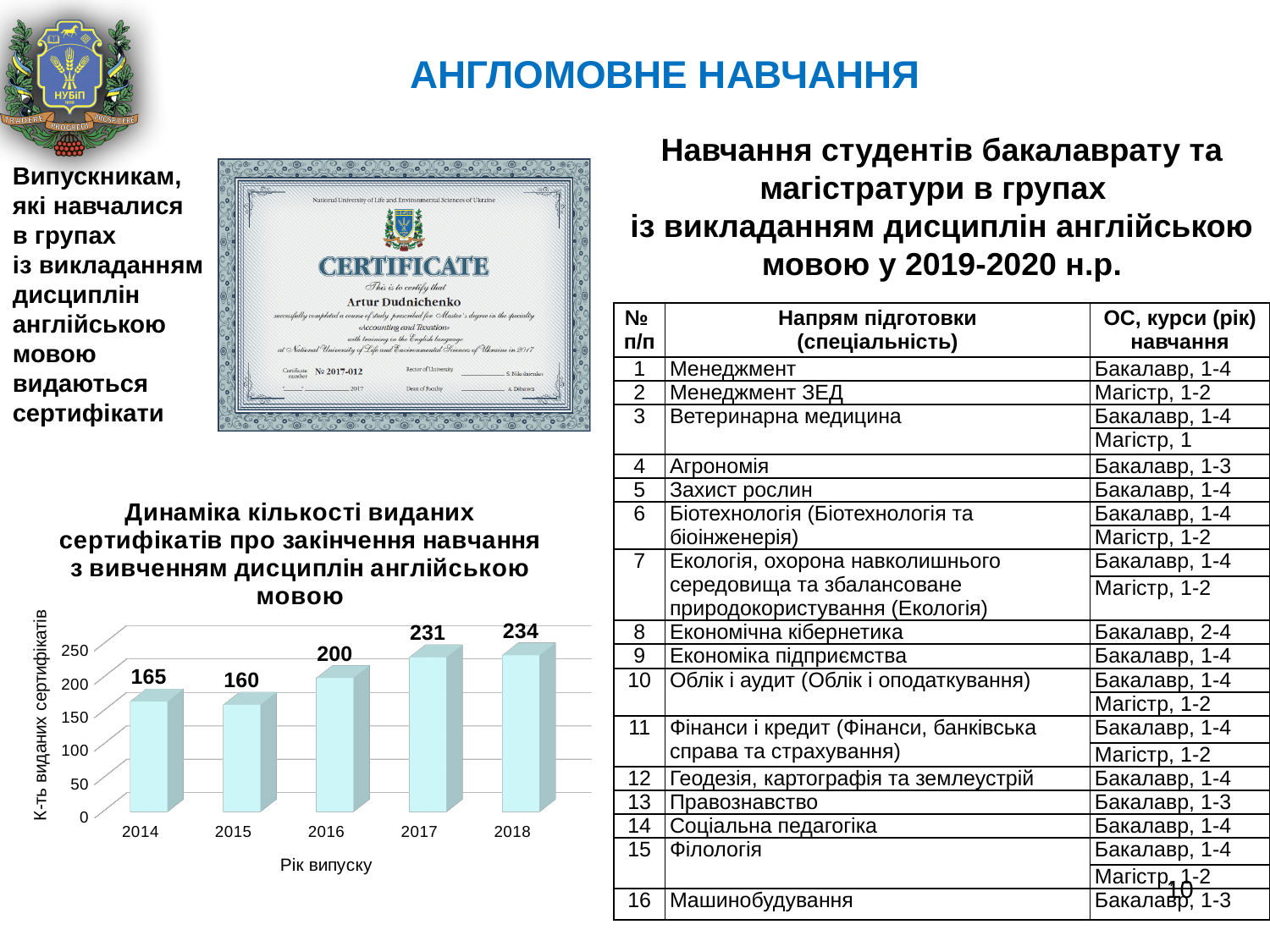
What is the value for 2014 in the chart? 165 Which year has the highest value in the chart? 2018 What is the label of the x axis of the chart? Рік випуску What is the difference between the values for 2017 and 2016? 31 Is the value for 2016 greater or less than 150? greater Which is larger, the value for 2014 or the value for 2015? 2014 What is the value for 2017 in the chart? 231 How many years are shown on the x axis of the chart? 5 Which year has the lowest value in the chart? 2015 What is the value for 2016 in the chart? 200 What is the difference between the values for 2018 and 2014? 69 What kind of chart is shown on the slide? bar chart